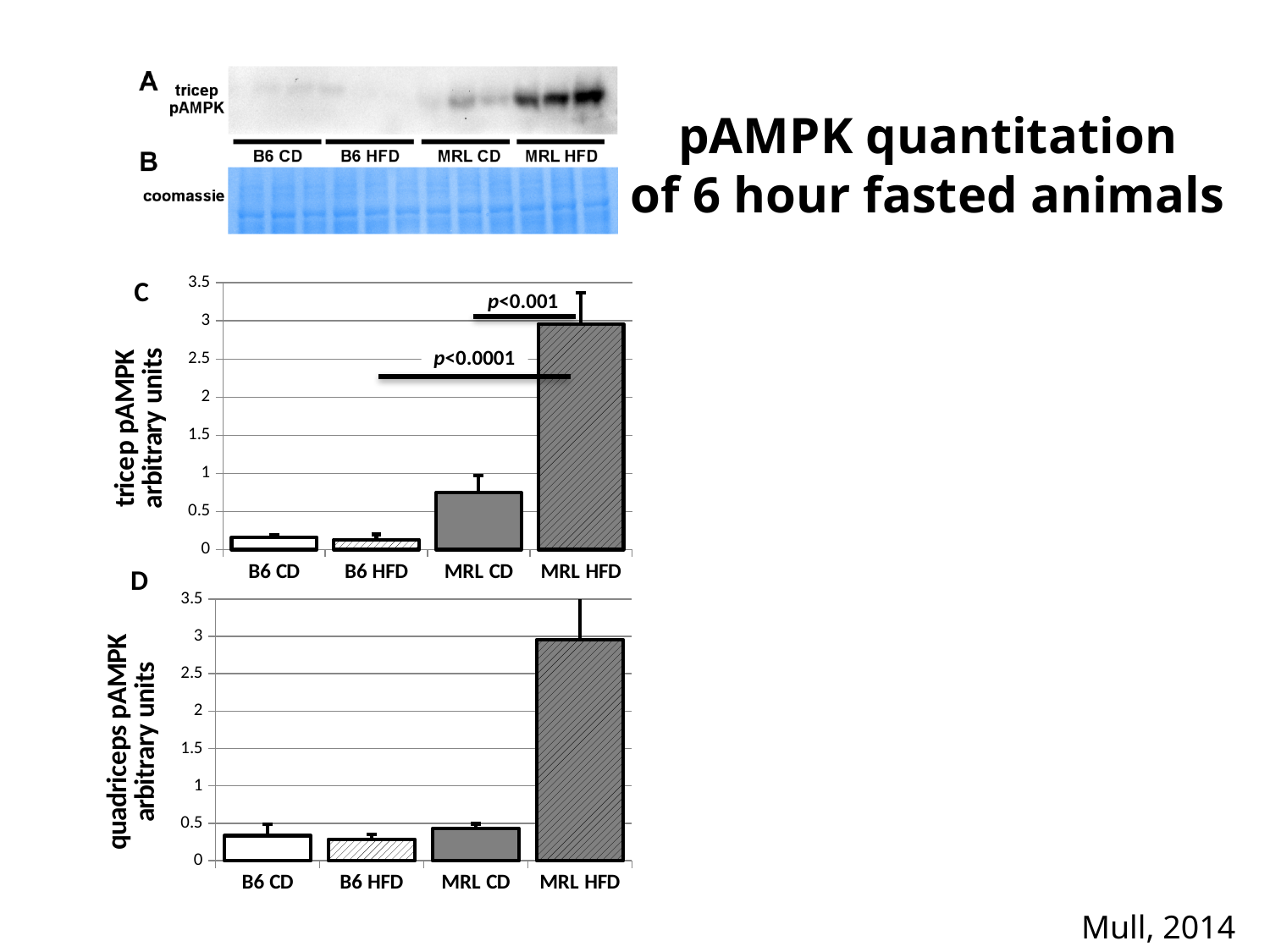
In chart D (quadriceps pAMPK), is the value for MRL HFD greater or less than 2.5? greater In chart C (tricep pAMPK), which category has the highest value? MRL HFD In chart C (tricep pAMPK), is the value for MRL CD greater or less than 1? less In chart C (tricep pAMPK), what kind of chart is shown? bar chart In chart D, what is the label on the y axis? quadriceps pAMPK arbitrary units In chart C (tricep pAMPK), which is larger, the value for MRL CD or the value for B6 HFD? MRL CD In chart D (quadriceps pAMPK), is the value for B6 CD greater or less than 0.5? less In chart C (tricep pAMPK), how many categories are plotted on the x axis? 4 In chart D (quadriceps pAMPK), which category has the highest value? MRL HFD In chart D (quadriceps pAMPK), which is larger, the value for MRL HFD or the value for MRL CD? MRL HFD In chart C (tricep pAMPK), what p-value is shown for the comparison between MRL CD and MRL HFD? p<0.001